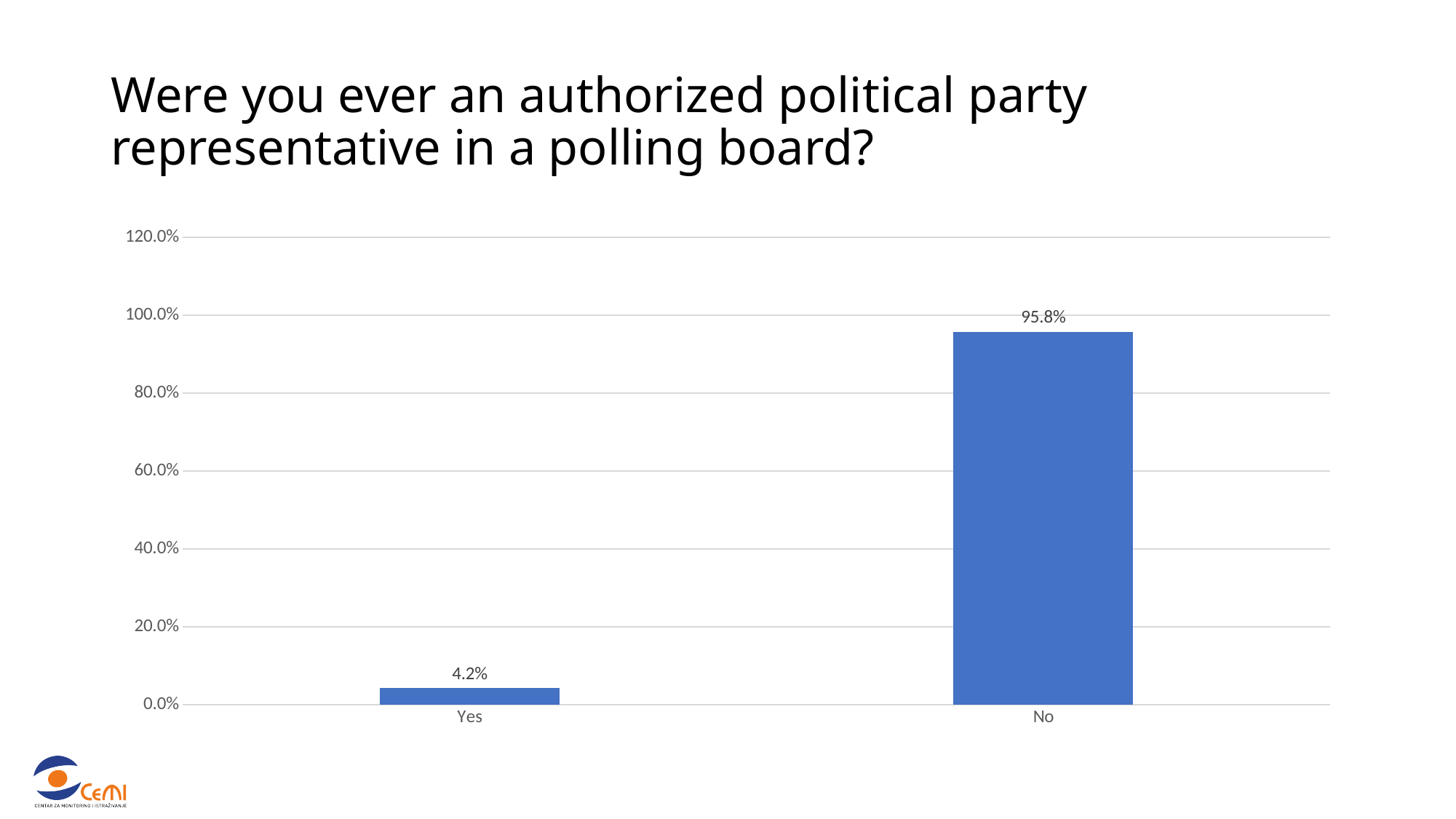
What is the value for "No"? 95.8% What question does the slide title ask? Were you ever an authorized political party representative in a polling board? What is the difference between the values for "No" and "Yes"? 91.6% Which category has the lowest value? Yes Which category has the highest value? No What is the value for "Yes"? 4.2% How many categories are shown on the x axis? 2 What kind of chart is shown on the slide? Bar chart Is the value for "No" greater or less than 80.0%? greater Is the value for "Yes" greater or less than 20.0%? less Which is larger, the value for "Yes" or the value for "No"? No What is the highest value shown on the y axis? 120.0%